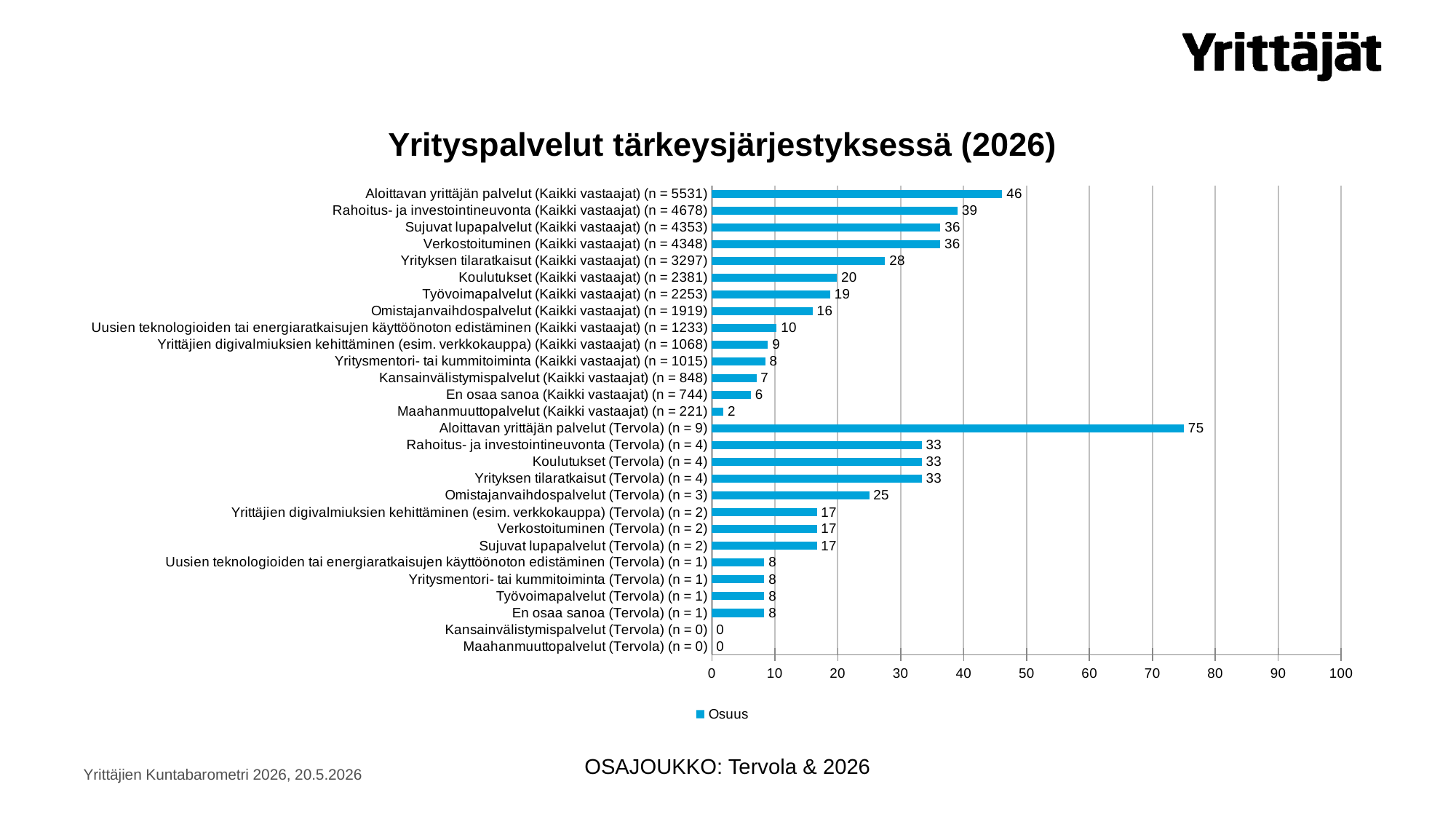
What is the difference between the values for Aloittavan yrittäjän palvelut (Tervola) (n = 9) and Aloittavan yrittäjän palvelut (Kaikki vastaajat) (n = 5531)? 29 What is the value for Aloittavan yrittäjän palvelut (Kaikki vastaajat) (n = 5531)? 46 What is the value for Maahanmuuttopalvelut (Kaikki vastaajat) (n = 221)? 2 What is the value for Aloittavan yrittäjän palvelut (Tervola) (n = 9)? 75 What is the title of the chart? Yrityspalvelut tärkeysjärjestyksessä (2026) How many series does the legend list? 1 Which category has the highest value in the chart? Aloittavan yrittäjän palvelut (Tervola) (n = 9) What kind of chart is shown on the slide? bar chart How many categories are plotted in the chart? 28 What is the value for Omistajanvaihdospalvelut (Tervola) (n = 3)? 25 Is the value for Yrityksen tilaratkaisut (Kaikki vastaajat) (n = 3297) greater or less than 30? less Which is larger: the value for Rahoitus- ja investointineuvonta (Kaikki vastaajat) (n = 4678) or Rahoitus- ja investointineuvonta (Tervola) (n = 4)? Rahoitus- ja investointineuvonta (Kaikki vastaajat) (n = 4678)